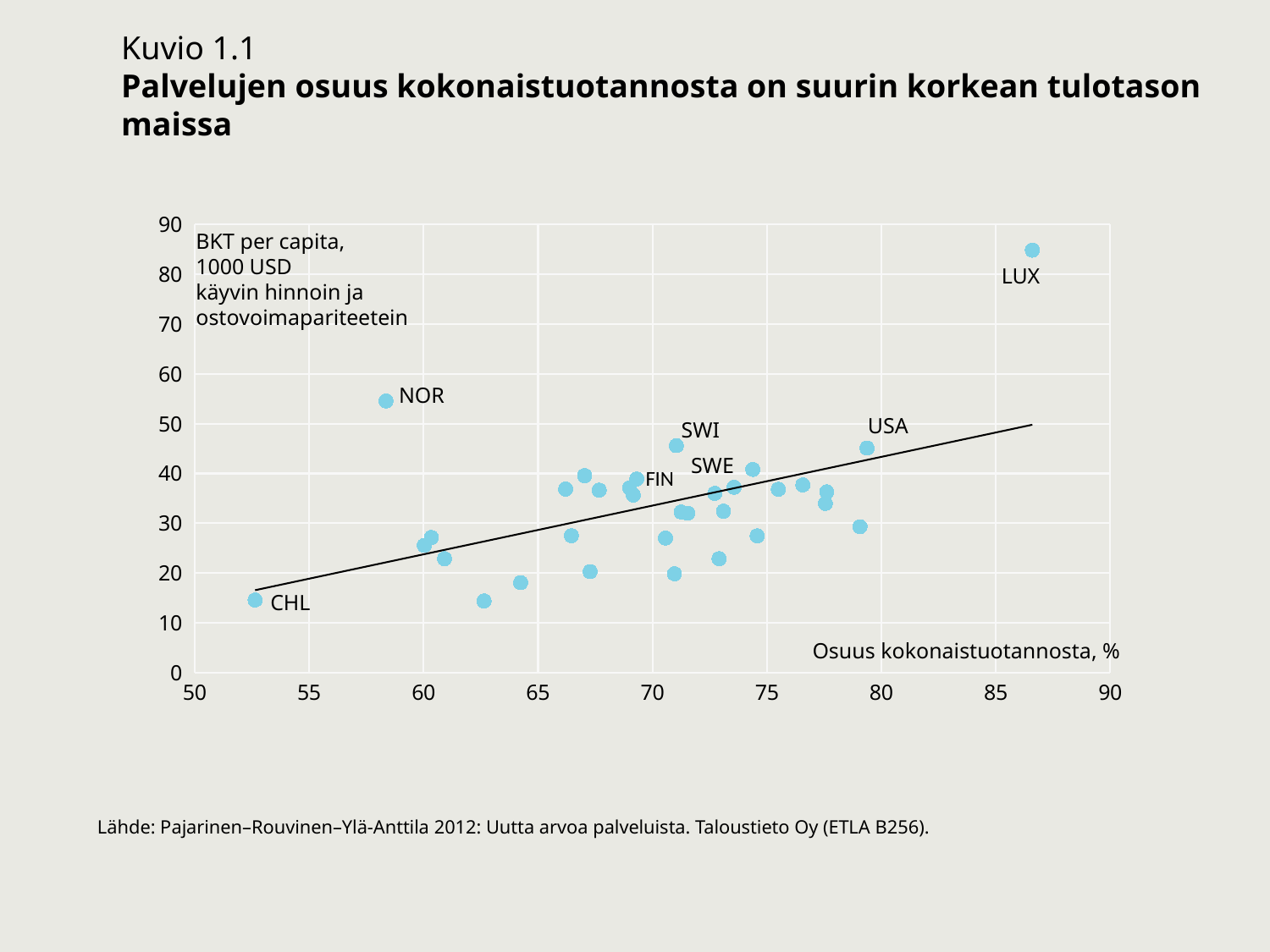
Is the GDP per capita value for NOR greater or less than 50? greater How many points on the chart are labelled with a country code? 7 Which labelled country has the lowest GDP per capita (BKT per capita) on the chart? CHL Is the GDP per capita value for CHL greater or less than 20? less Is the share of services in total output (x axis) for CHL greater or less than 55? less Which has the higher GDP per capita, NOR or USA? NOR Which has the higher GDP per capita, FIN or CHL? FIN Which labelled country has the highest GDP per capita (BKT per capita) on the chart? LUX According to the trend line, does GDP per capita rise or fall as the share of services in total output increases? rise What kind of chart is shown on the slide? scatter chart